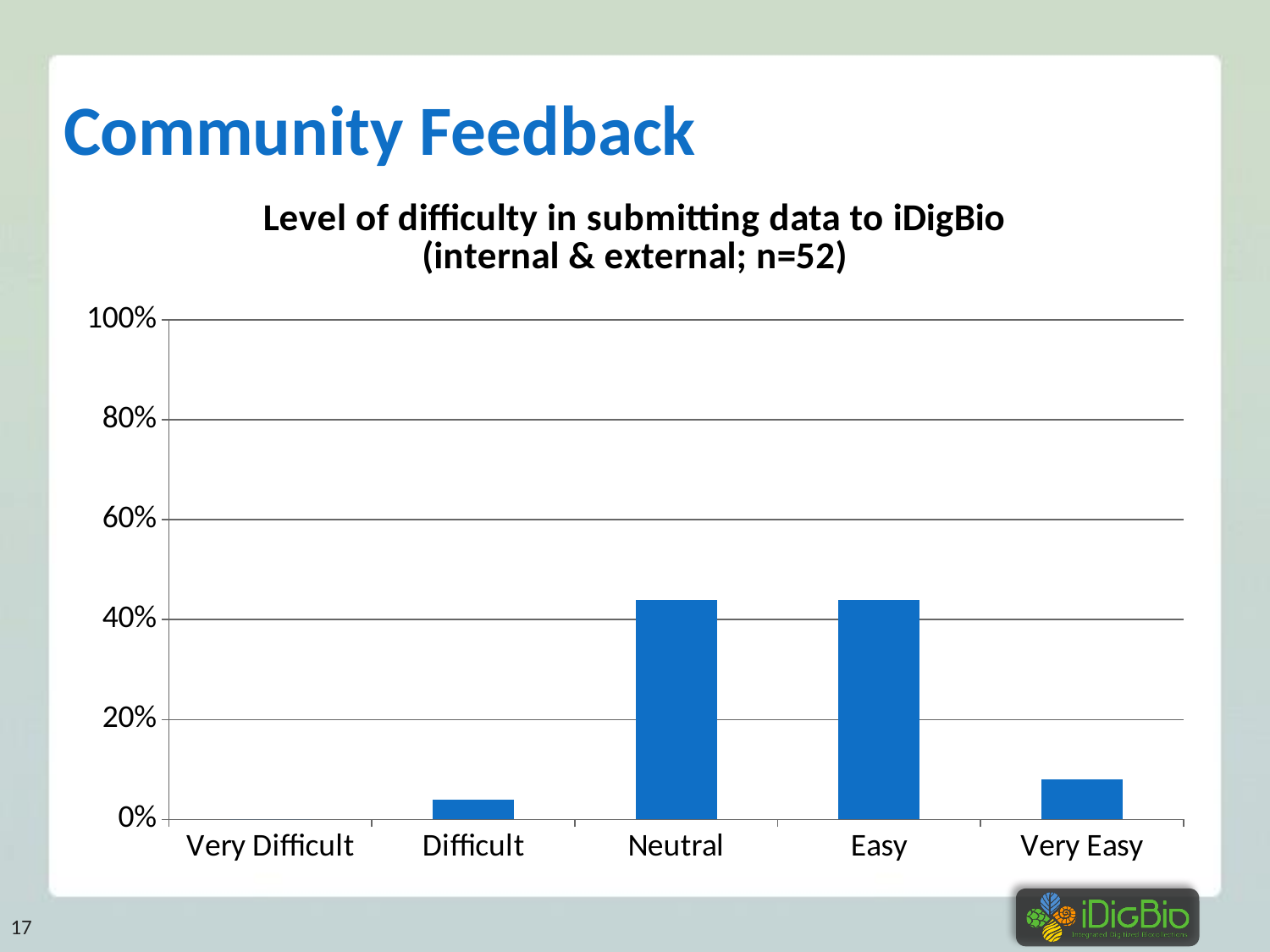
How many categories are shown on the x axis of the chart? 5 Which category has the lowest value in the chart? Very Difficult Which is larger, the value for Easy or the value for Difficult? Easy Which is larger, the value for Difficult or the value for Very Easy? Very Easy What kind of chart is shown on the slide? Bar chart Is the value for Neutral greater or less than 40%? greater What is the highest value shown on the y axis of the chart? 100% What is the title of the chart? Level of difficulty in submitting data to iDigBio (internal & external; n=52) Is the value for Difficult greater or less than 20%? less Which is larger, the value for Neutral or the value for Very Easy? Neutral Is the value for Very Easy greater or less than 20%? less